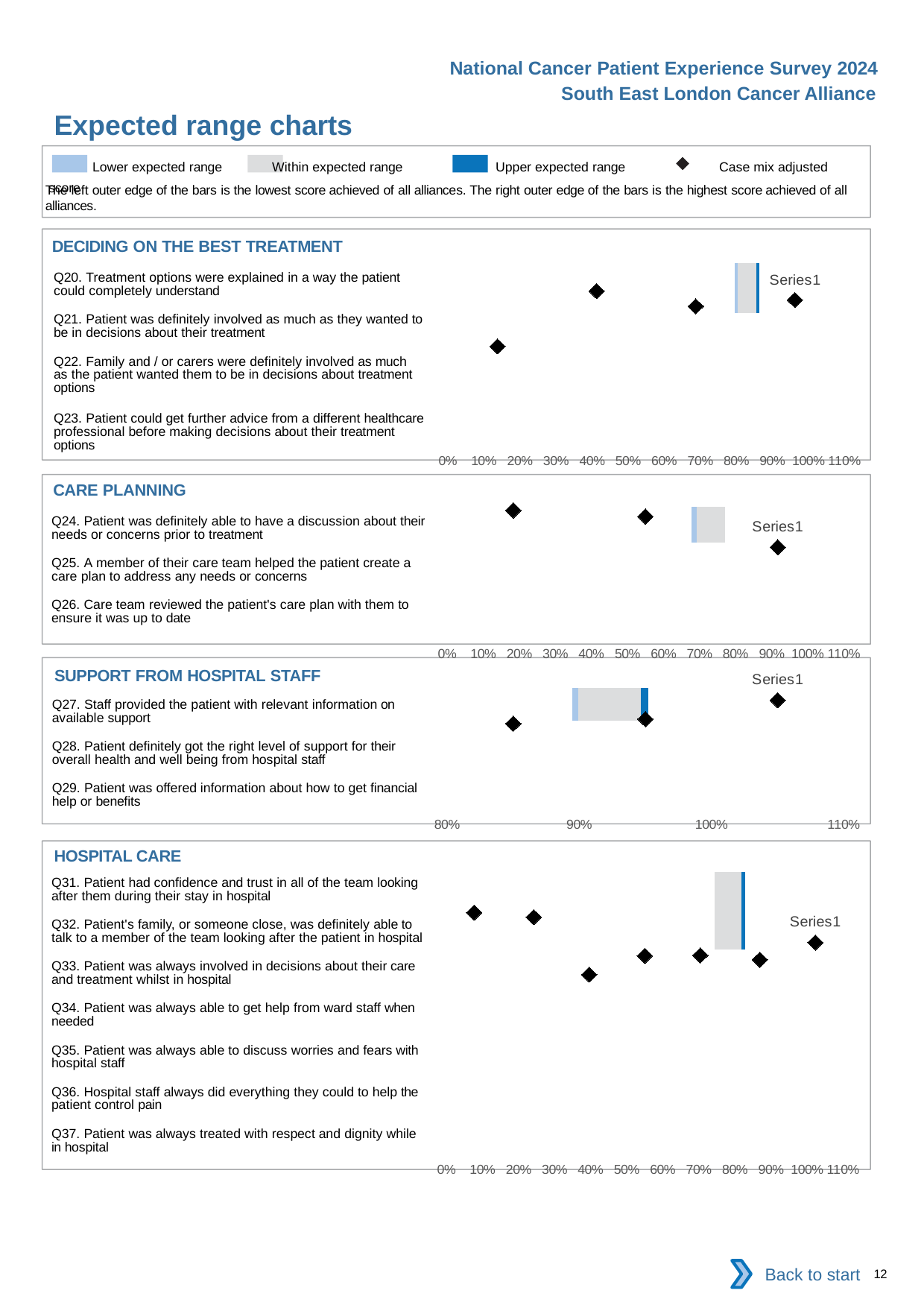
In the SUPPORT FROM HOSPITAL STAFF chart, how many diamond markers are plotted? 3 In the HOSPITAL CARE chart, is the value of the rightmost diamond marker greater or less than 80%? greater What legend entry is shown inside each chart's plot area? Series1 How many charts are shown on the slide? 4 In the CARE PLANNING chart, is the value of the leftmost diamond marker greater or less than 30%? less In the CARE PLANNING chart, how many diamond markers are plotted? 3 In the DECIDING ON THE BEST TREATMENT chart, is the value of the leftmost diamond marker greater or less than 20%? less What is the lowest x-axis tick label shown on the SUPPORT FROM HOSPITAL STAFF chart? 80%